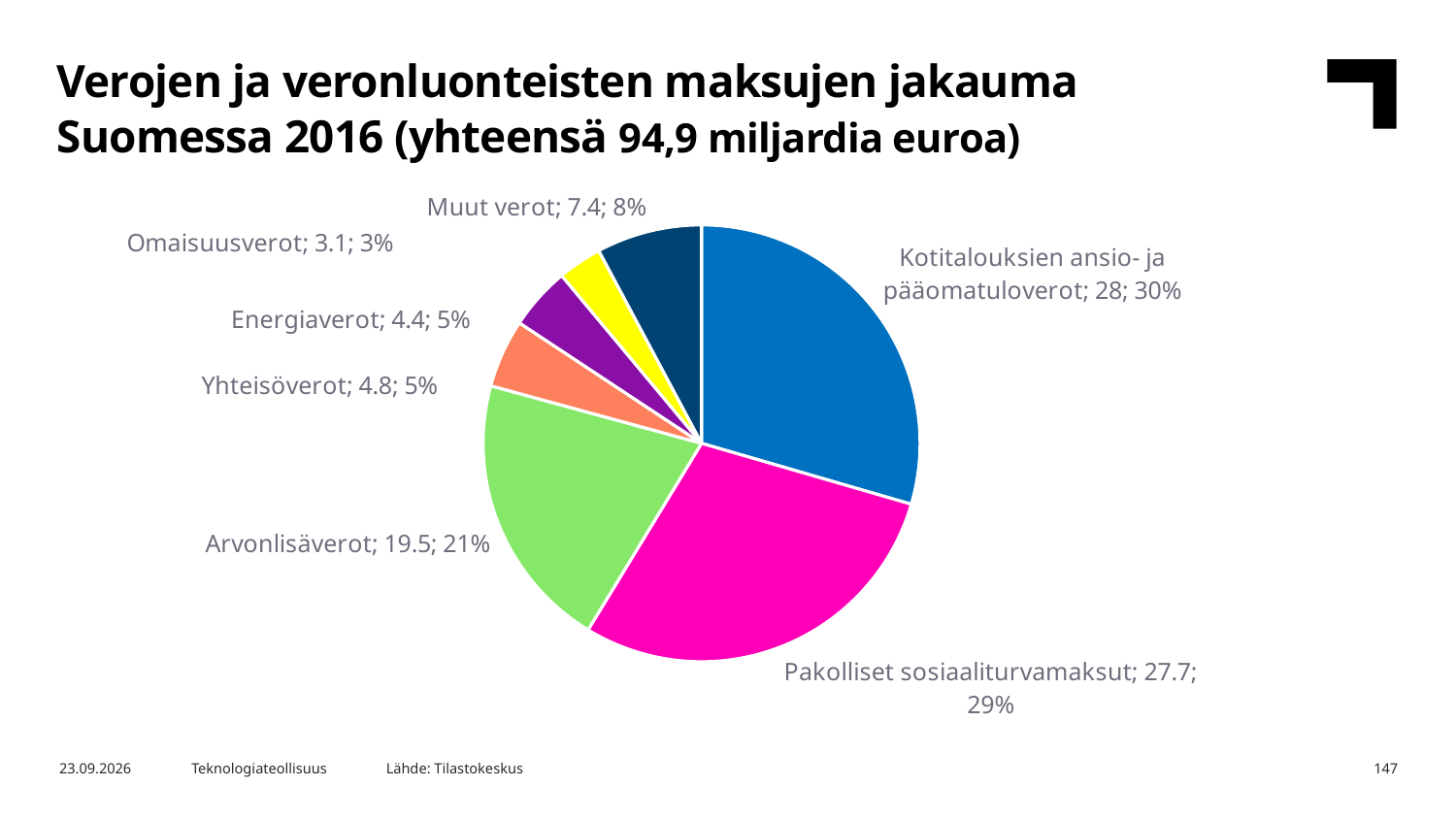
What is the value shown for Arvonlisäverot? 19.5 What is the difference between the values for Kotitalouksien ansio- ja pääomatuloverot and Pakolliset sosiaaliturvamaksut? 0.3 Which category has the smallest slice of the pie? Omaisuusverot What is the difference between the values for Yhteisöverot and Energiaverot? 0.4 What percentage share is shown for Omaisuusverot? 3% What kind of chart is shown on the slide? Pie chart What total amount in billions of euros is stated in the chart title? 94,9 miljardia euroa What is the value shown for Muut verot? 7.4 How many slices does the pie chart have? 7 Which category has the largest slice of the pie? Kotitalouksien ansio- ja pääomatuloverot What percentage share is shown for Pakolliset sosiaaliturvamaksut? 29% Which is larger, the value for Muut verot or the value for Yhteisöverot? Muut verot